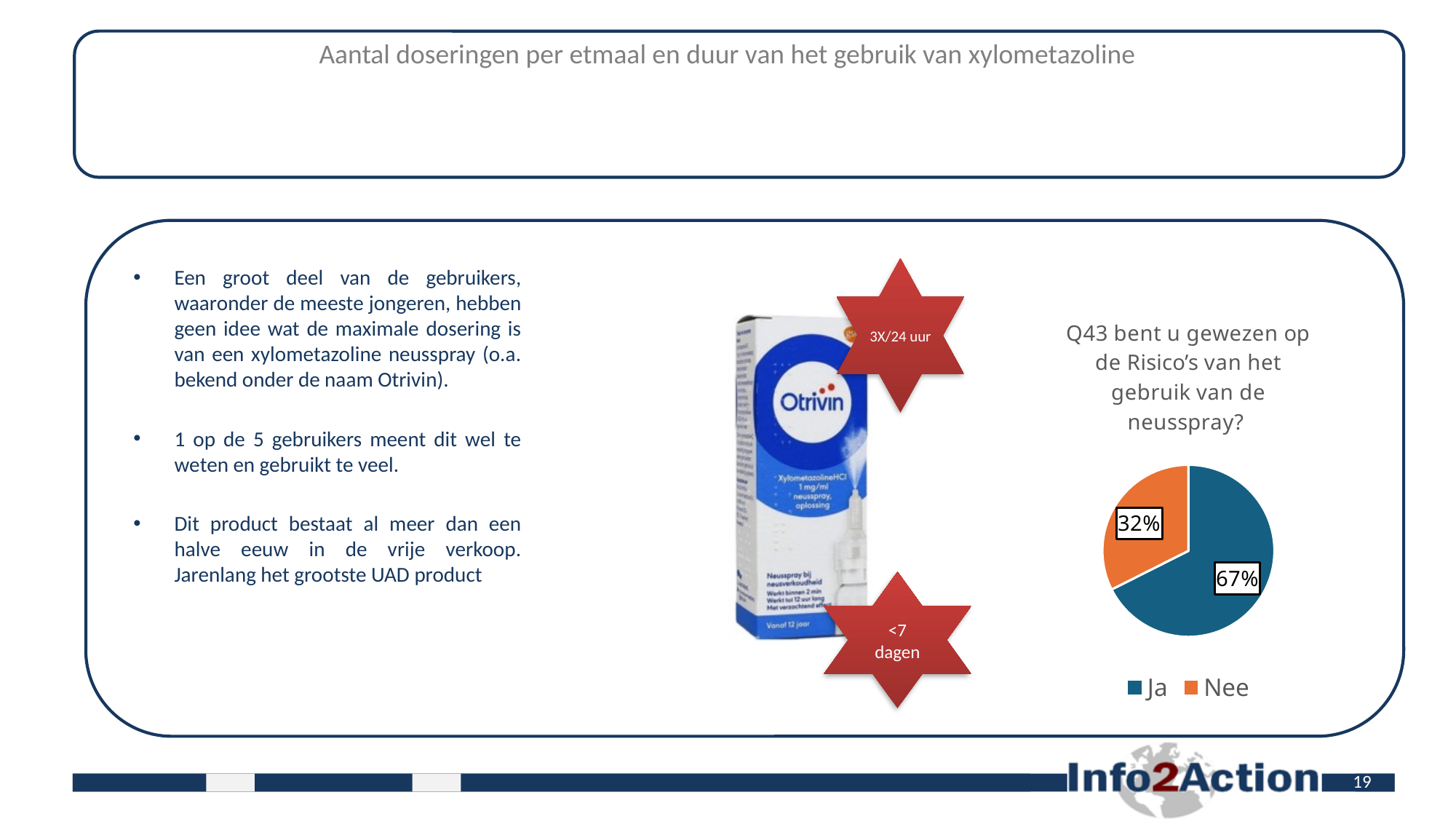
Which slice is larger, "Ja" or "Nee"? Ja What is the difference in percentage points between the "Ja" and "Nee" slices? 35 Which category has the largest share in the pie chart? Ja What percentage of respondents answered "Ja" in the pie chart? 67% How many slices does the pie chart have? 2 What percentage of respondents answered "Nee" in the pie chart? 32% What is the title of the pie chart? Q43 bent u gewezen op de Risico's van het gebruik van de neusspray? What colour is the "Nee" slice in the pie chart? orange What kind of chart is shown on the slide? pie chart How many categories does the legend of the pie chart list? 2 Which category has the smallest share in the pie chart? Nee